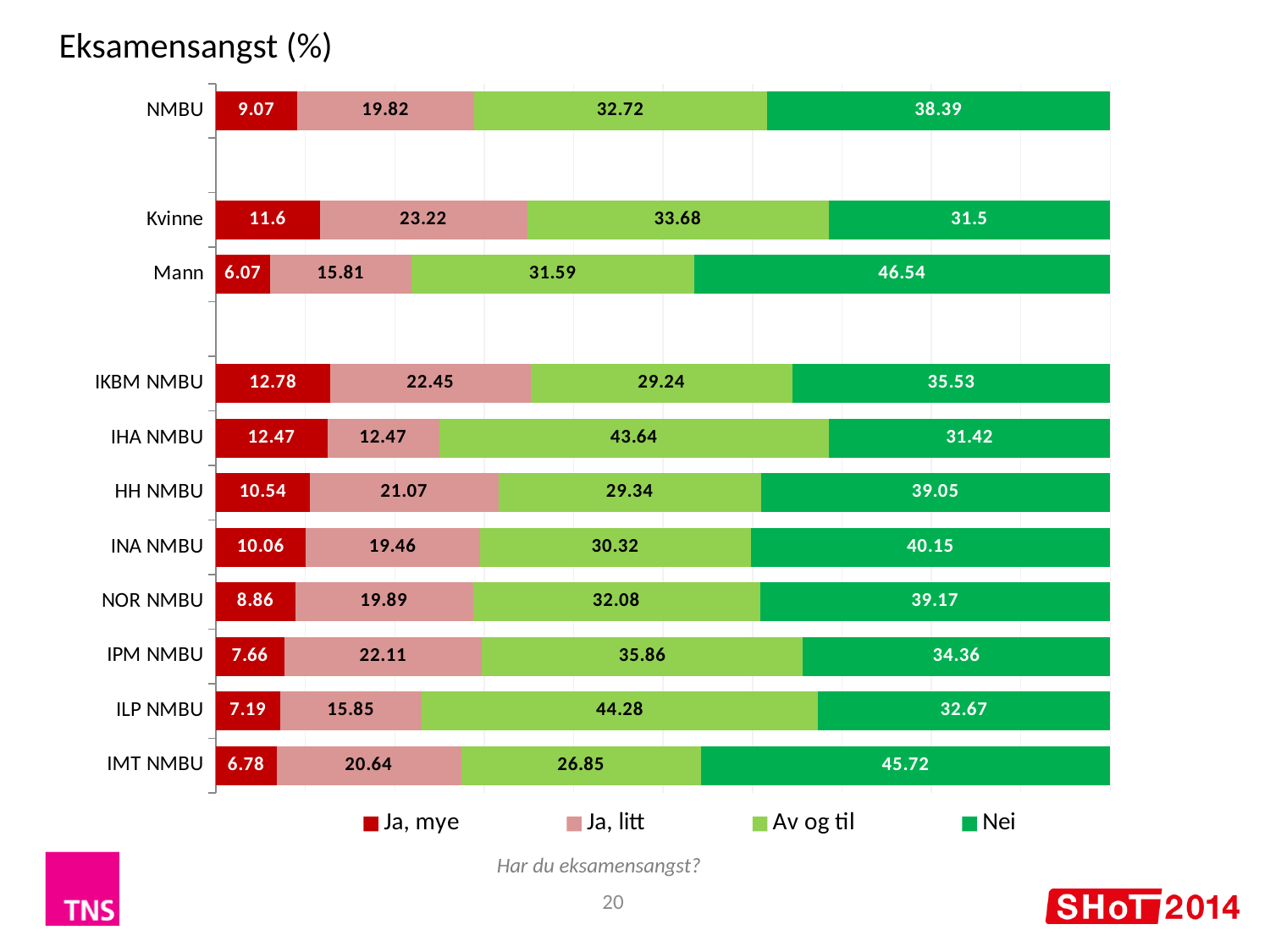
How many categories are shown on the y axis of the chart? 11 How many series does the legend list? 4 What is the difference between the "Ja, litt" values for Kvinne and Mann? 7.41 What is the value of "Ja, mye" for IKBM NMBU? 12.78 What is the value of "Nei" for Mann? 46.54 What is the value of "Av og til" for ILP NMBU? 44.28 Which category has the lowest value for "Ja, mye"? Mann What kind of chart is shown on the slide? Stacked bar chart Which category has the highest value for "Nei"? Mann What is the title of the chart? Eksamensangst (%) Which has a larger "Av og til" value, IHA NMBU or IKBM NMBU? IHA NMBU What is the difference between the "Nei" values for Mann and Kvinne? 15.04